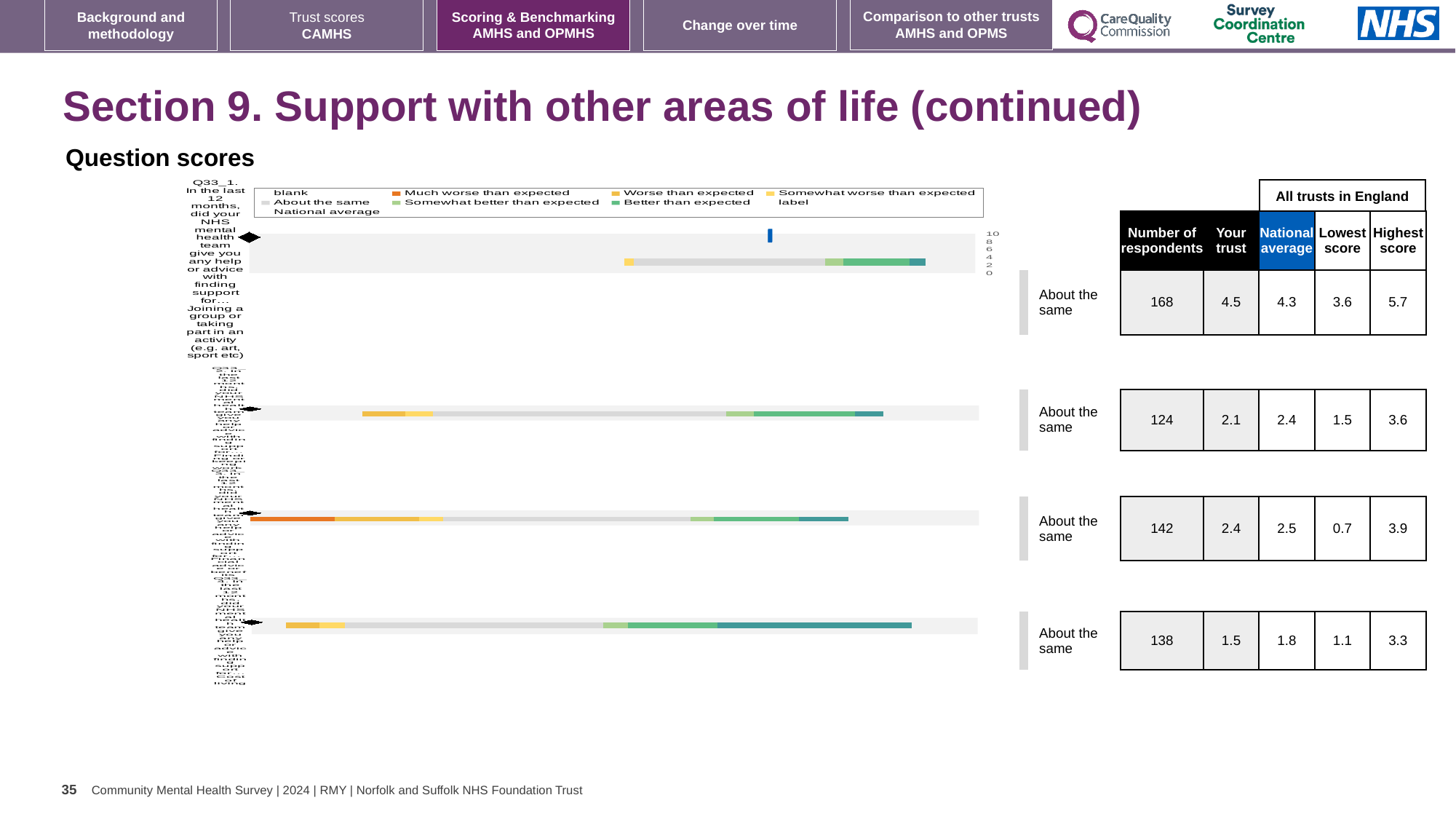
In the table beside the chart, what is the national average for the second bar? 2.4 What benchmark label is shown to the right of each bar in the chart? About the same For the first (top) bar, what is the difference between the highest score and the lowest score in the table? 2.1 In the table beside the chart, what is the number of respondents for the first (top) bar? 168 What kind of chart is shown under 'Question scores'? bar chart In the table beside the chart, what is the lowest score for the third bar? 0.7 In the table beside the chart, what is the 'Your trust' score for the first (top) bar? 4.5 Which bar has the largest number of respondents according to the table beside the chart? the first (top) bar, 168 Which question number is the first (top) bar of the chart about? Q33_1 How many horizontal bars does the chart contain? 4 For the first (top) bar, is the 'Your trust' score or the national average larger? Your trust (4.5) In the table beside the chart, what is the highest score for the fourth (bottom) bar? 3.3